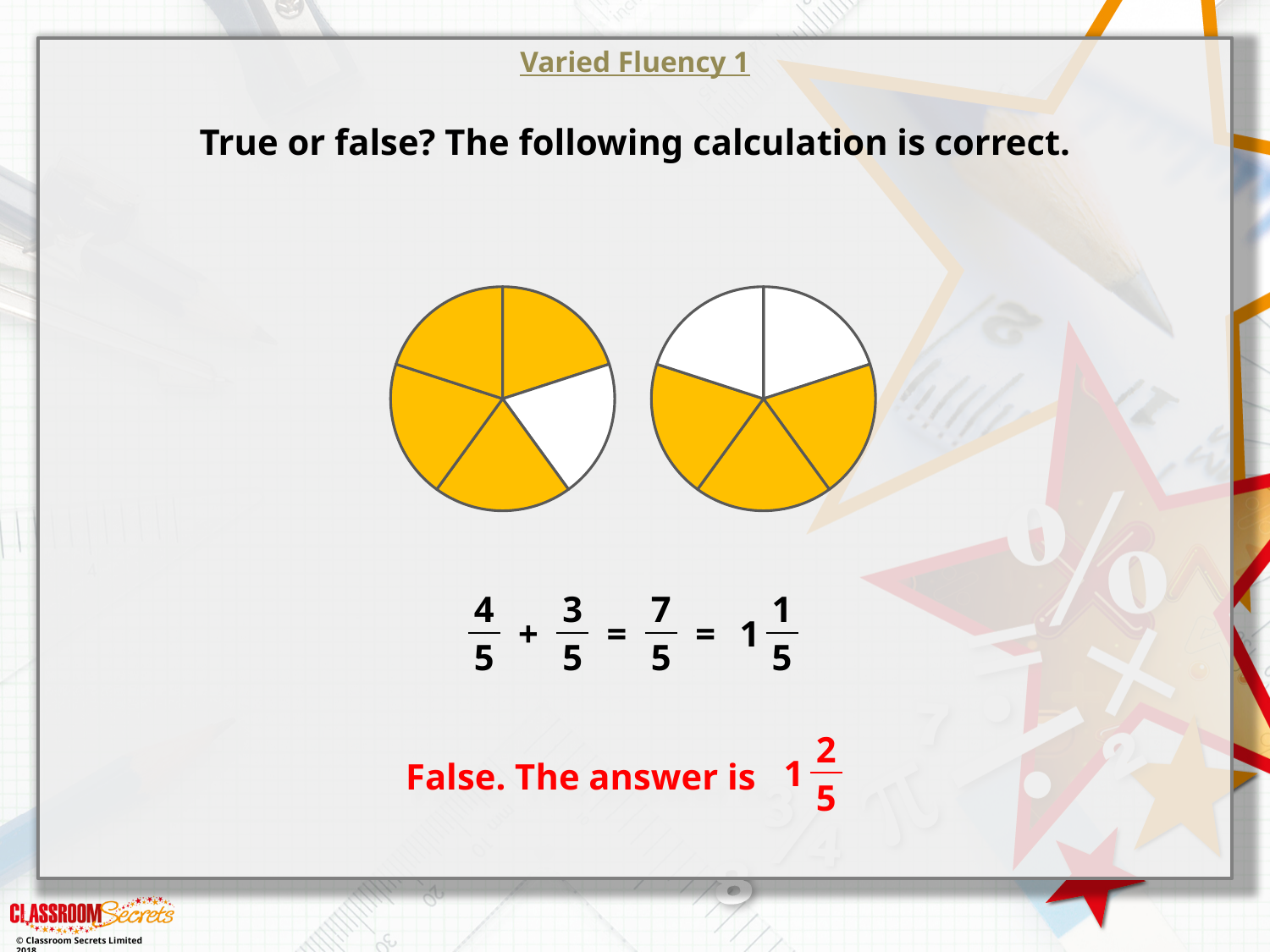
According to the red text, what is the correct answer to the calculation shown? 1 2/5 What colour are the shaded parts of the circles? yellow How many parts of the left circle are shaded yellow? 4 How many parts of the right circle are left unshaded? 2 How many equal parts is the left circle divided into? 5 What fraction of the left circle is shaded, as written in the calculation below it? 4/5 What fraction of the right circle is shaded, as written in the calculation below it? 3/5 Which circle has more shaded parts, the left or the right? left What kind of chart are the two diagrams on the slide? pie chart